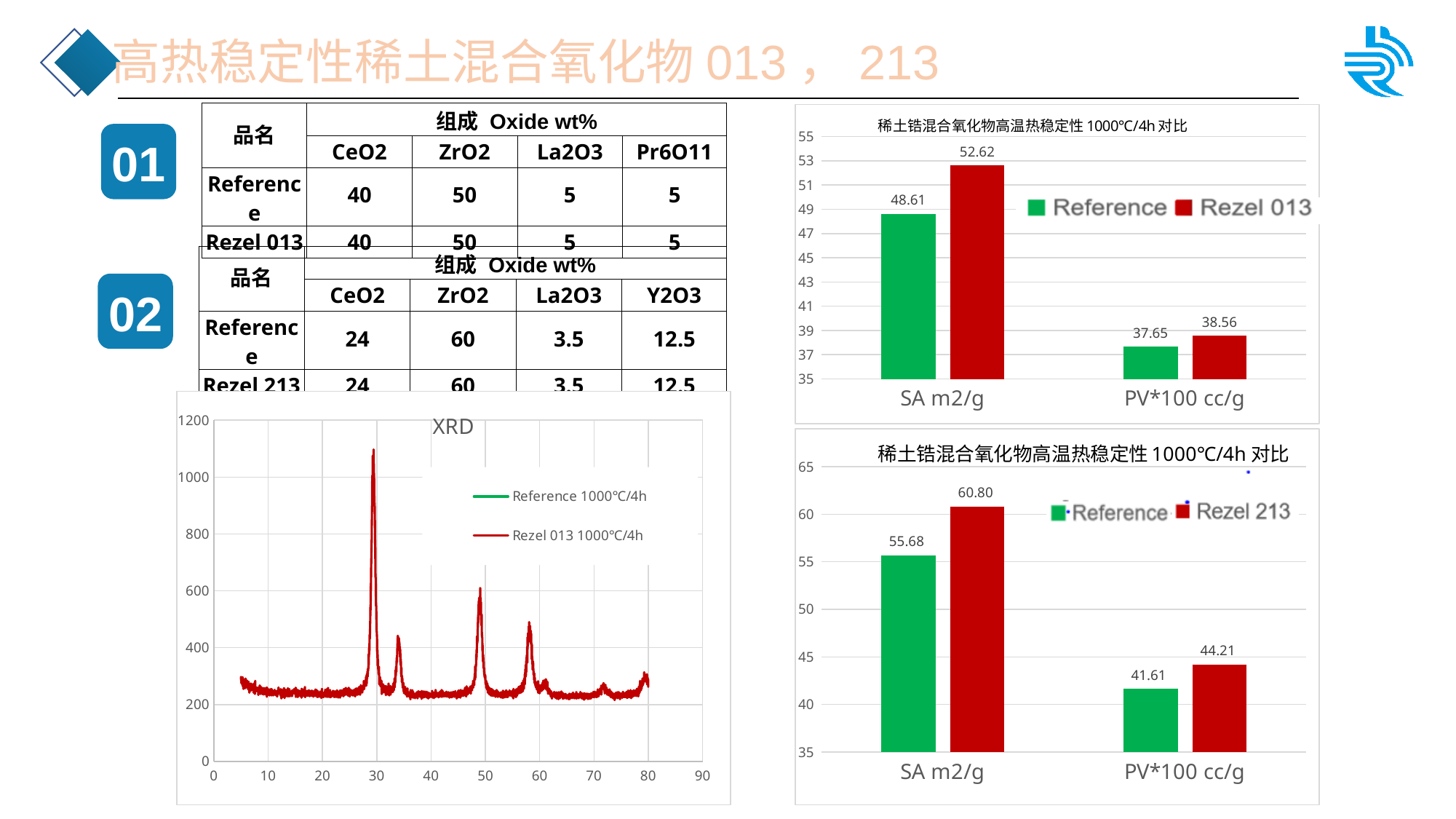
How many series does the legend of the XRD chart list? 2 In the bottom-right bar chart, what is the PV*100 cc/g value for Reference? 41.61 How many series does the legend of the bottom-right bar chart list? 2 In the top-right bar chart, what is the difference between the SA m2/g values of Rezel 013 and Reference? 4.01 In the top-right bar chart, what is the PV*100 cc/g value for Reference? 37.65 In the top-right bar chart, what is the SA m2/g value for Rezel 013? 52.62 In the bottom-right bar chart, what is the SA m2/g value for Rezel 213? 60.80 What kind of chart is the XRD chart at the bottom left? Line chart In the bottom-right bar chart, which bar is the highest? Rezel 213, SA m2/g In the top-right bar chart, which series has the higher PV*100 cc/g value, Reference or Rezel 013? Rezel 013 In the top-right bar chart, what colour are the Rezel 013 bars? Red In the bottom-right bar chart, what is the difference between the PV*100 cc/g values of Rezel 213 and Reference? 2.60